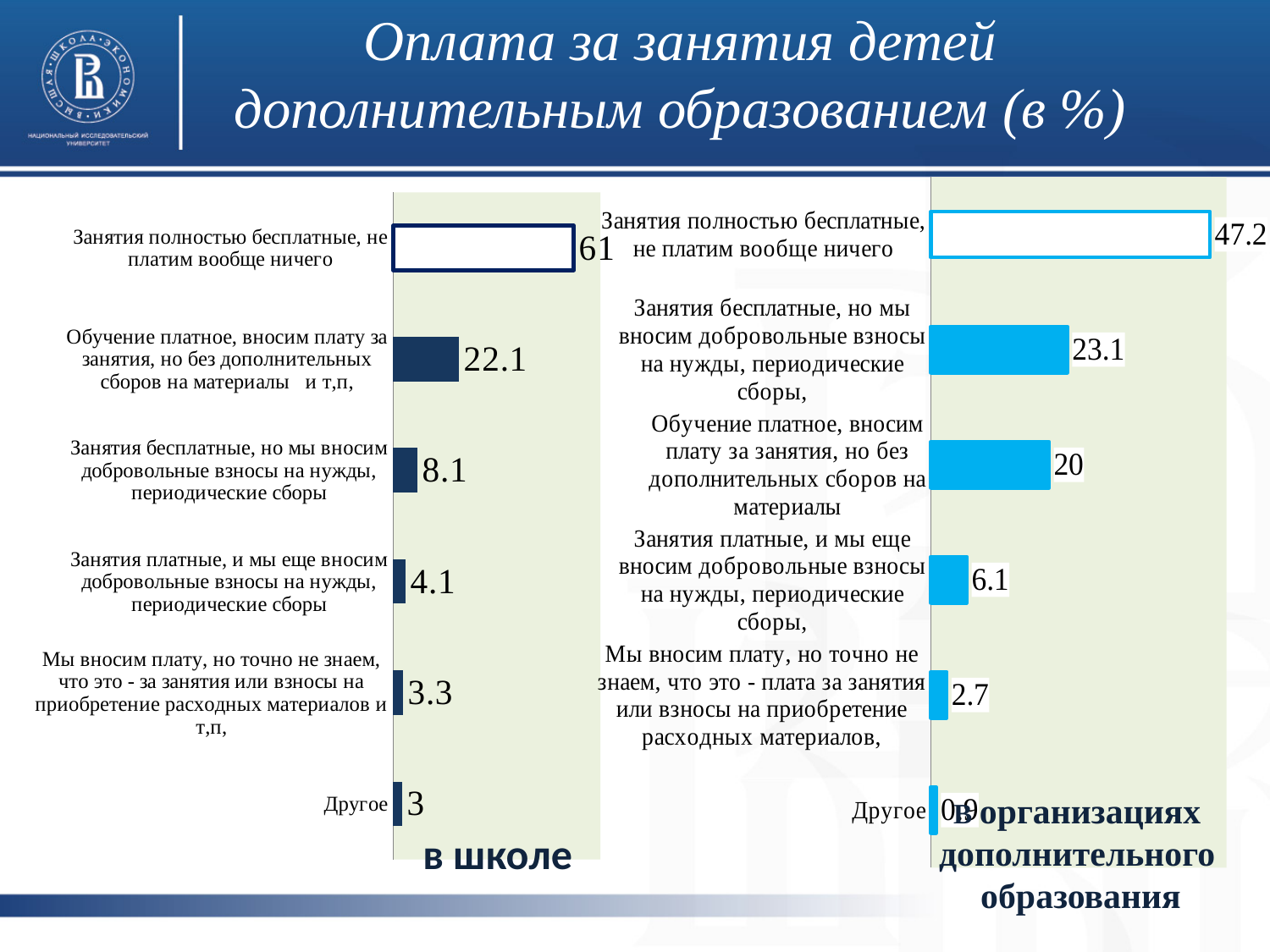
In the chart titled 'в организациях дополнительного образования', what is the value for 'Занятия полностью бесплатные, не платим вообще ничего'? 47.2 Which is larger: the value for 'Занятия полностью бесплатные, не платим вообще ничего' in the chart titled 'в школе' or in the chart titled 'в организациях дополнительного образования'? в школе In the chart titled 'в школе', what is the value for 'Занятия полностью бесплатные, не платим вообще ничего'? 61 How many categories are shown in the chart titled 'в школе'? 6 In the chart titled 'в организациях дополнительного образования', what is the value for 'Занятия бесплатные, но мы вносим добровольные взносы на нужды, периодические сборы,'? 23.1 In the chart titled 'в организациях дополнительного образования', what is the difference between the values for 'Занятия бесплатные, но мы вносим добровольные взносы на нужды, периодические сборы,' and 'Обучение платное, вносим плату за занятия, но без дополнительных сборов на материалы'? 3.1 In the chart titled 'в школе', which category has the highest value? Занятия полностью бесплатные, не платим вообще ничего In the chart titled 'в школе', what is the value for 'Обучение платное, вносим плату за занятия, но без дополнительных сборов на материалы и т,п,'? 22.1 In the chart titled 'в школе', what is the difference between the values for 'Занятия полностью бесплатные, не платим вообще ничего' and 'Обучение платное, вносим плату за занятия, но без дополнительных сборов на материалы и т,п,'? 38.9 In the chart titled 'в школе', what is the value for 'Другое'? 3 In the chart titled 'в организациях дополнительного образования', which category has the lowest value? Другое What type of chart is the chart titled 'в организациях дополнительного образования'? Bar chart